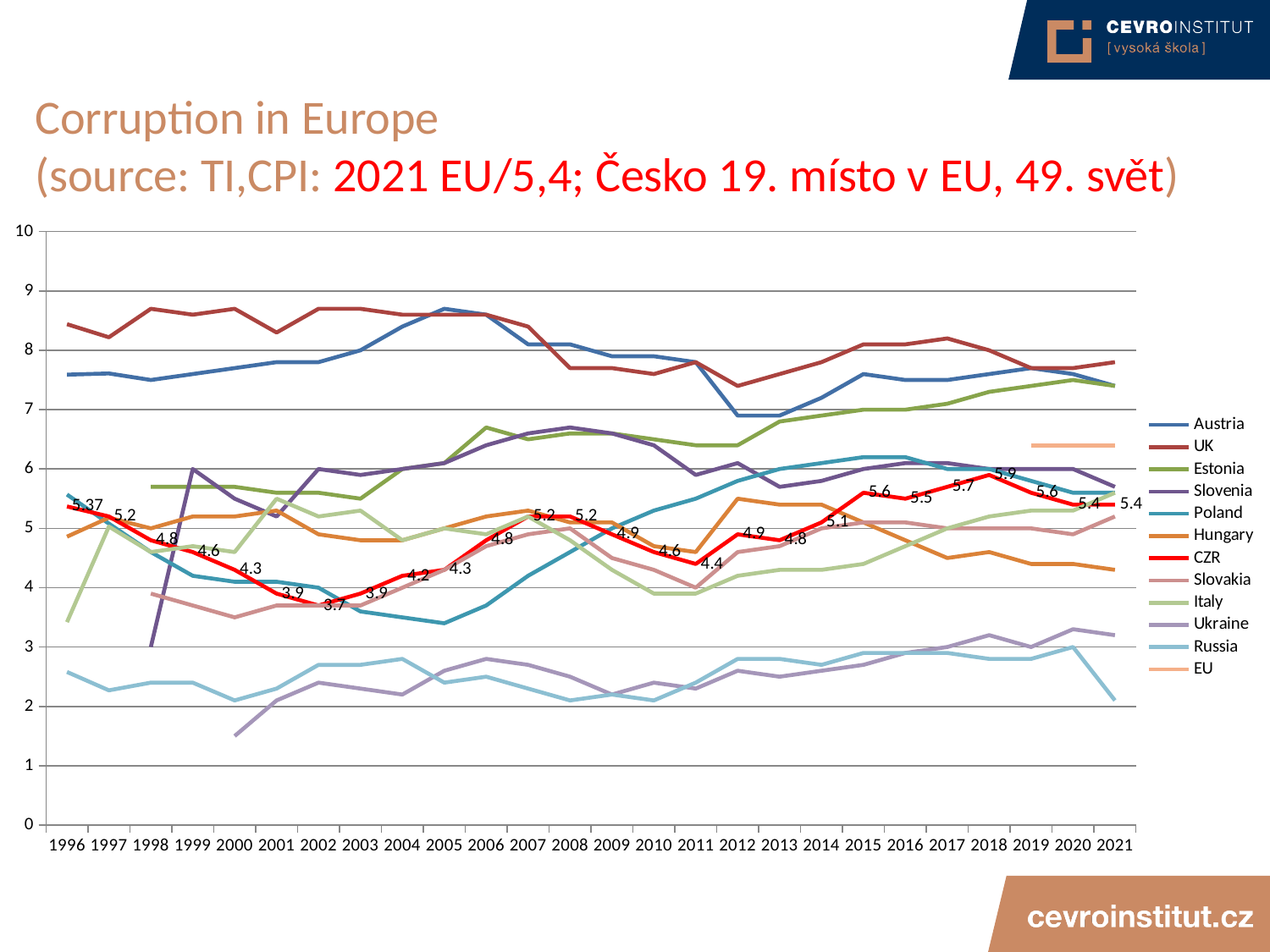
What is the CZR value for 2018? 5.9 What is the difference between the CZR values for 2018 and 2002? 2.2 In which year is the CZR value lowest? 2002 Is the value for Russia in 2021 greater or less than 3? less Does the CZR series rise or fall from 2011 to 2018? rise Which series has the higher value in 2012, UK or Austria? UK How many years are shown along the x axis? 26 How many series does the legend list? 12 In which year is the CZR value highest? 2018 What kind of chart is shown on the slide? line chart What is the CZR value for 2002? 3.7 What is the CZR value for 2021? 5.4